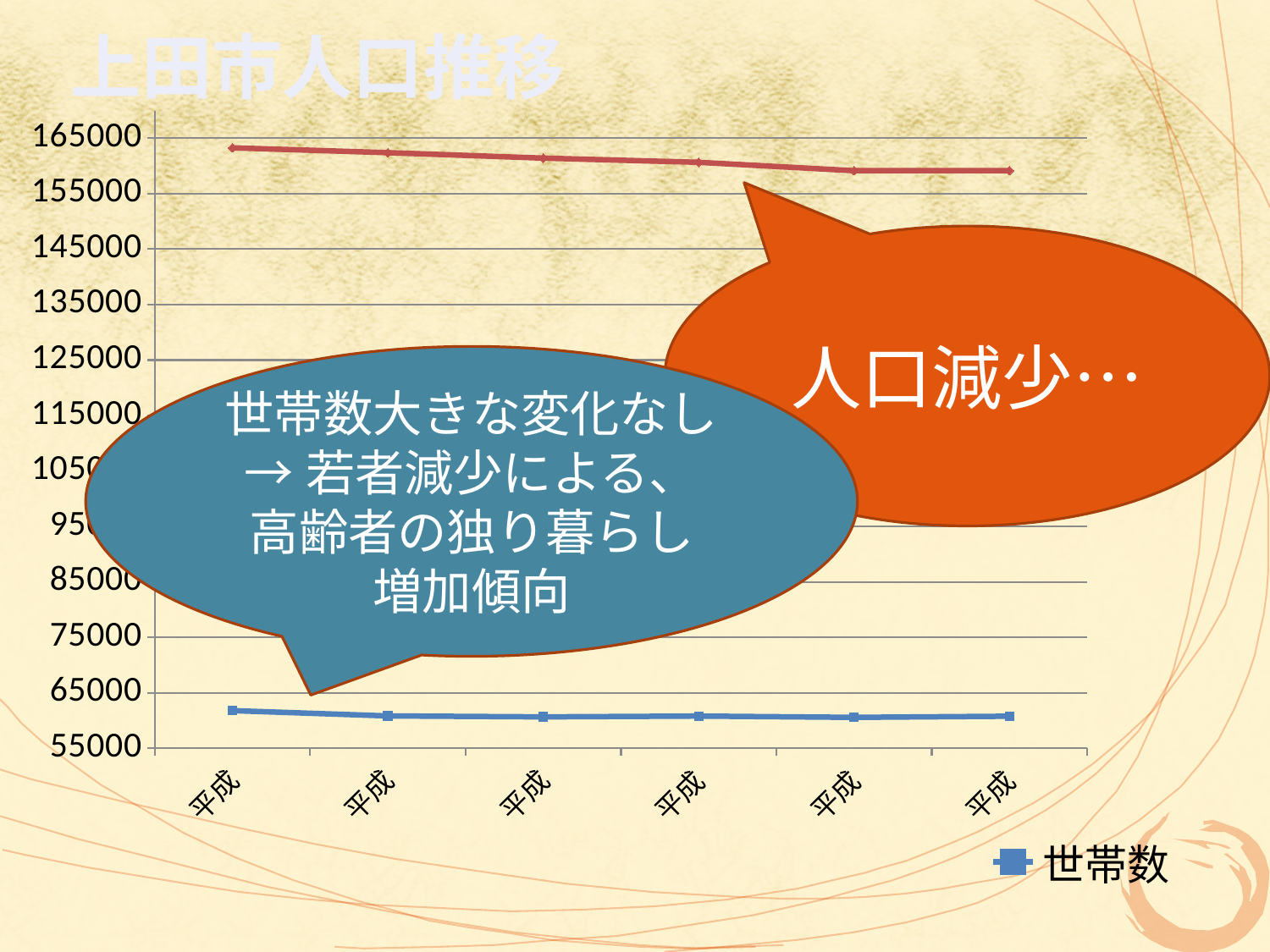
Which series name is shown in the chart legend? 世帯数 What is the title of the chart? 上田市人口推移 What kind of chart is shown on the slide? line chart Is the value of the rightmost point on the 世帯数 line greater or less than 55000? greater How many lines are plotted on the chart? 2 At which point along the x axis is the red (upper) line highest? the leftmost point Is the value of the leftmost point on the red (upper) line greater or less than 155000? greater How many data points does each line have along the x axis? 6 Is the value of the leftmost point on the 世帯数 line greater or less than 65000? less Which line has higher values throughout, the red line or the 世帯数 line? the red line Does the red (upper) line rise or fall from left to right? fall